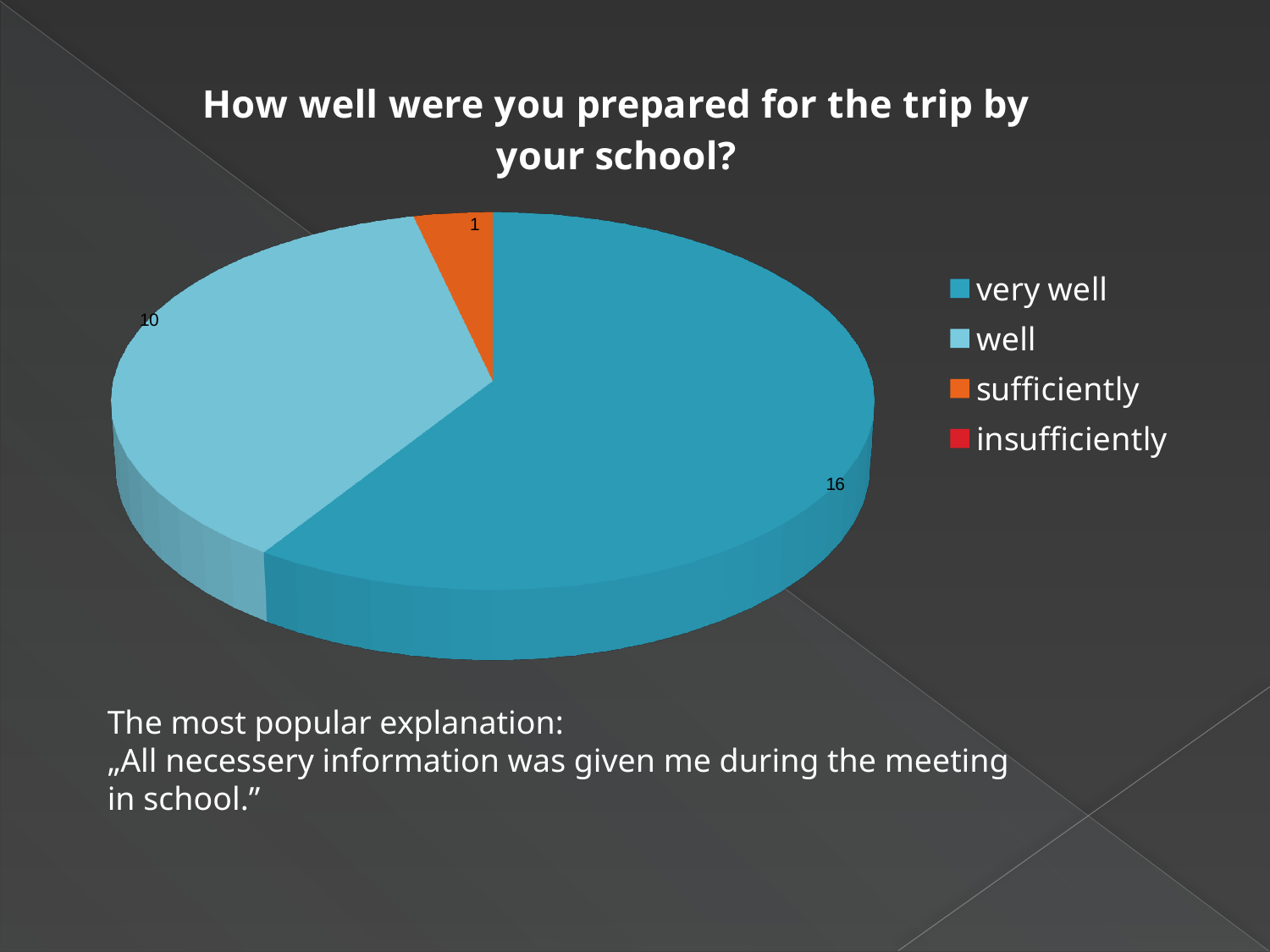
Which labelled slice is the smallest? sufficiently What is the value for "well"? 10 What kind of chart is shown on the slide? pie chart What is the difference between the values for "very well" and "well"? 6 What is the value for "very well"? 16 What is the difference between the values for "well" and "sufficiently"? 9 What is the title of the chart? How well were you prepared for the trip by your school? Which is larger, the value for "very well" or the value for "well"? very well What is the value for "sufficiently"? 1 How many entries does the legend list? 4 Which is larger, the value for "well" or the value for "sufficiently"? well Which category has the largest slice of the pie? very well